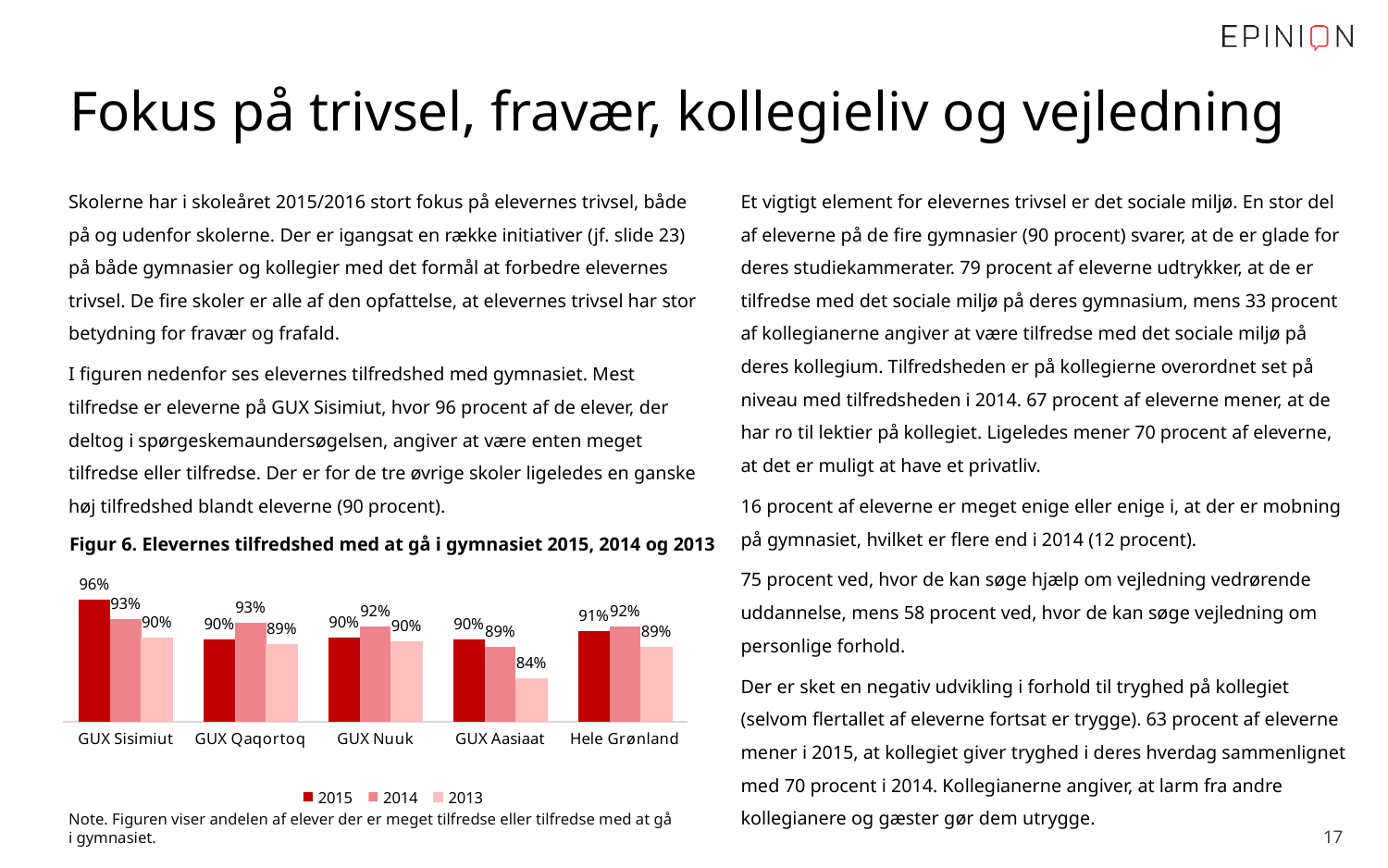
What is the difference between the 2014 and 2013 values for GUX Aasiaat? 5 percentage points What kind of chart is shown? Bar chart How many series does the legend list? 3 What is the difference between the 2015 and 2013 values for GUX Sisimiut? 6 percentage points What is the 2014 value for Hele Grønland? 92% What is the 2015 value for GUX Sisimiut? 96% What is the 2013 value for GUX Aasiaat? 84% What is the 2015 value for GUX Qaqortoq? 90% Which is larger for GUX Qaqortoq: the 2015 value or the 2014 value? 2014 How many categories are shown on the x axis? 5 Which school has the highest 2015 value? GUX Sisimiut Which category has the lowest 2013 value? GUX Aasiaat